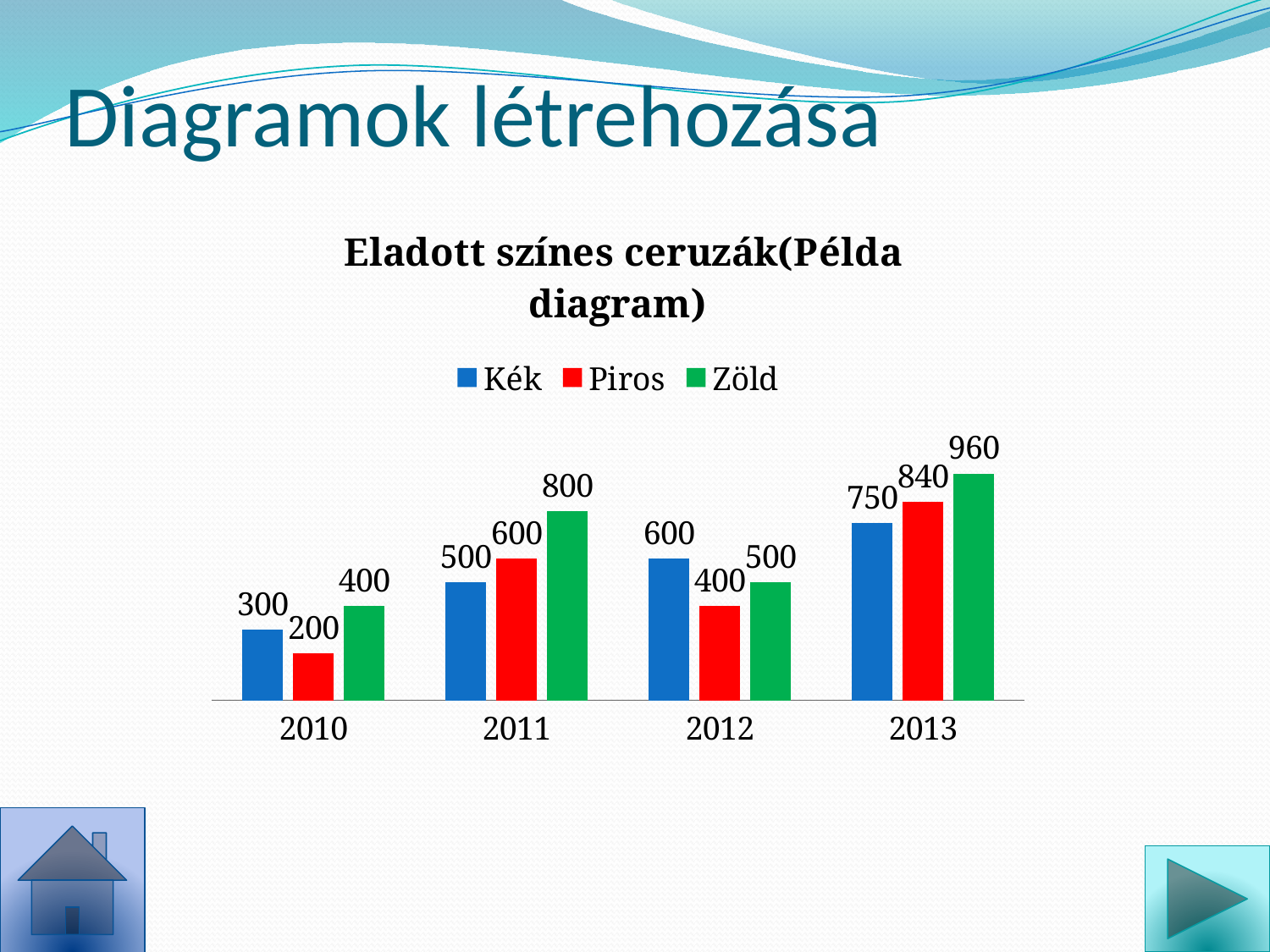
How many series does the legend list? 3 Which year has the lowest value for Piros? 2010 What is the difference between the Zöld and Kék values in 2011? 300 Does the value for Kék rise or fall from 2010 to 2013? rise Which year has the highest value for Zöld? 2013 Which is larger in 2012: the value for Kék or the value for Zöld? Kék What is the value for Zöld in 2013? 960 What colour represents the Piros series in the chart? red How many years are shown on the x axis? 4 What is the value for Kék in 2010? 300 What is the value for Piros in 2012? 400 What kind of chart is shown on the slide? bar chart